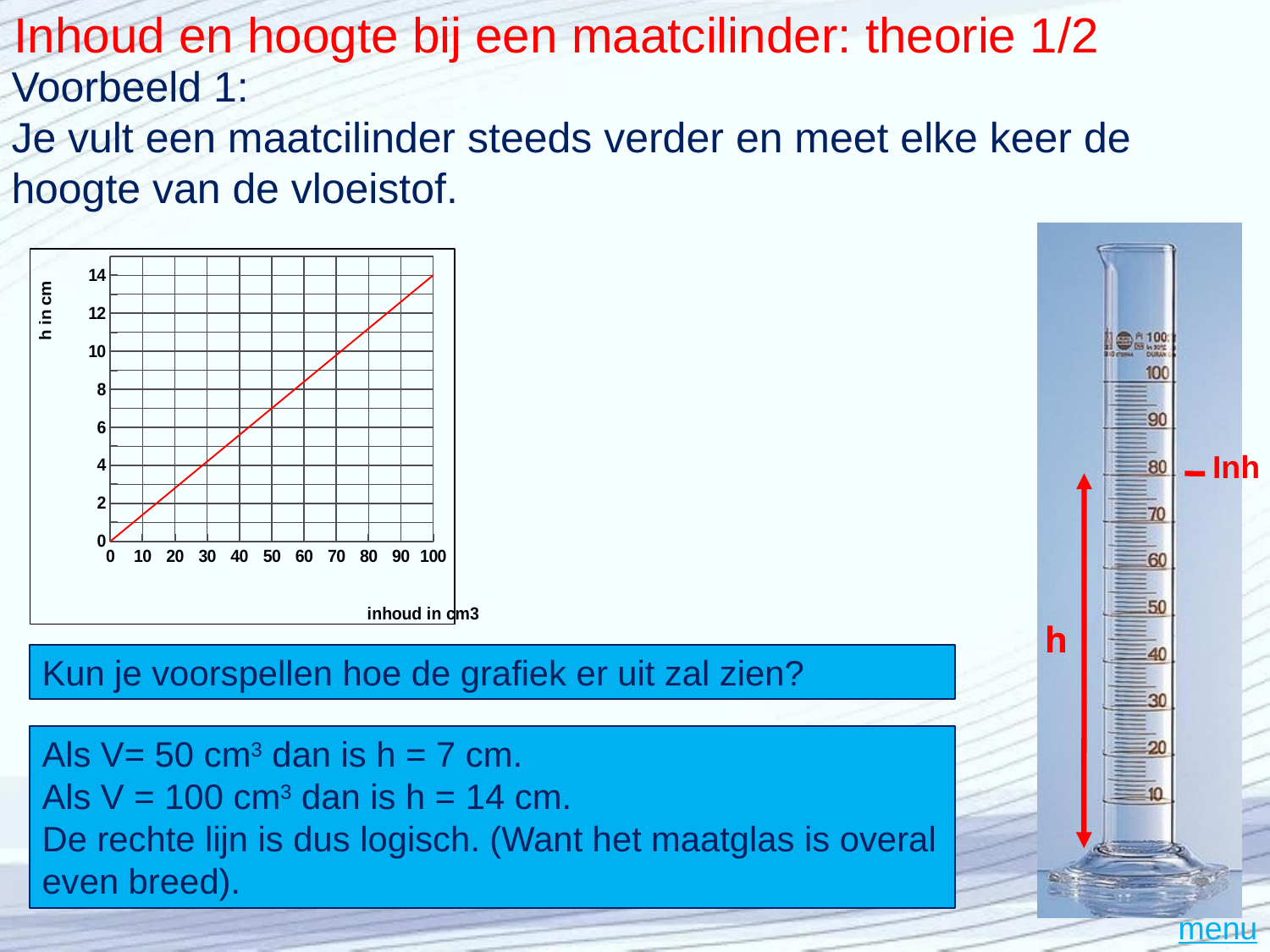
What colour is the plotted line in the chart? red What is the highest value shown on the y axis of the chart? 14 What is the difference in height h between an inhoud of 100 cm3 and an inhoud of 50 cm3? 7 cm Is the height h at an inhoud of 40 cm3 greater or less than 4? greater Which gives a larger height h: an inhoud of 50 cm3 or an inhoud of 100 cm3? 100 cm3 Does the height h rise or fall as the inhoud (volume) increases along the x axis? rises What is the height h when the inhoud is 50 cm3? 7 cm Is the height h at an inhoud of 80 cm3 greater or less than 10? greater Is the height h at an inhoud of 20 cm3 greater or less than 4? less What is the height h when the inhoud is 100 cm3? 14 cm What is the label of the x axis of the chart? inhoud in cm3 What kind of chart is shown on the slide? line chart